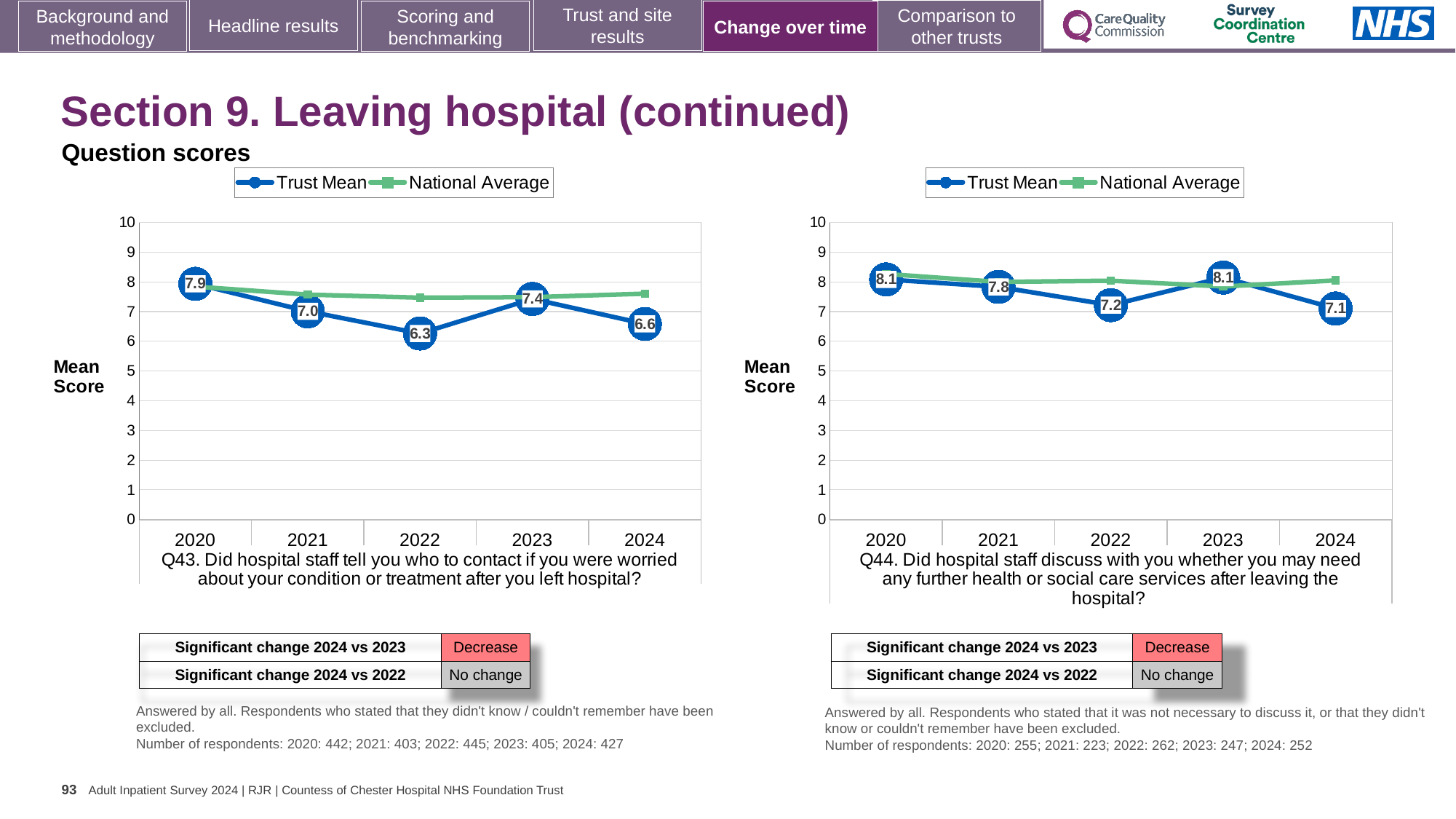
In the Q43 chart (left), which year has the highest Trust Mean score? 2020 In the Q44 chart (right), which year has the lowest Trust Mean score? 2024 How many series does the legend of the Q44 chart (right) list? 2 What type of chart is used for Q43 (left)? Line chart In the Q43 chart (left), is the Trust Mean score higher in 2021 or in 2023? 2023 In the Q44 chart (right), what is the Trust Mean score for 2021? 7.8 How many years are shown on the x axis of the Q43 chart (left)? 5 In the Q43 chart (left), does the Trust Mean score rise or fall from 2023 to 2024? Fall In the Q44 chart (right), is the National Average for 2024 greater or less than 7? greater In the Q44 chart (right), what is the difference between the Trust Mean scores for 2023 and 2024? 1.0 In the Q43 chart (left), what is the difference between the Trust Mean scores for 2020 and 2024? 1.3 In the Q43 chart (left), what is the Trust Mean score for 2022? 6.3